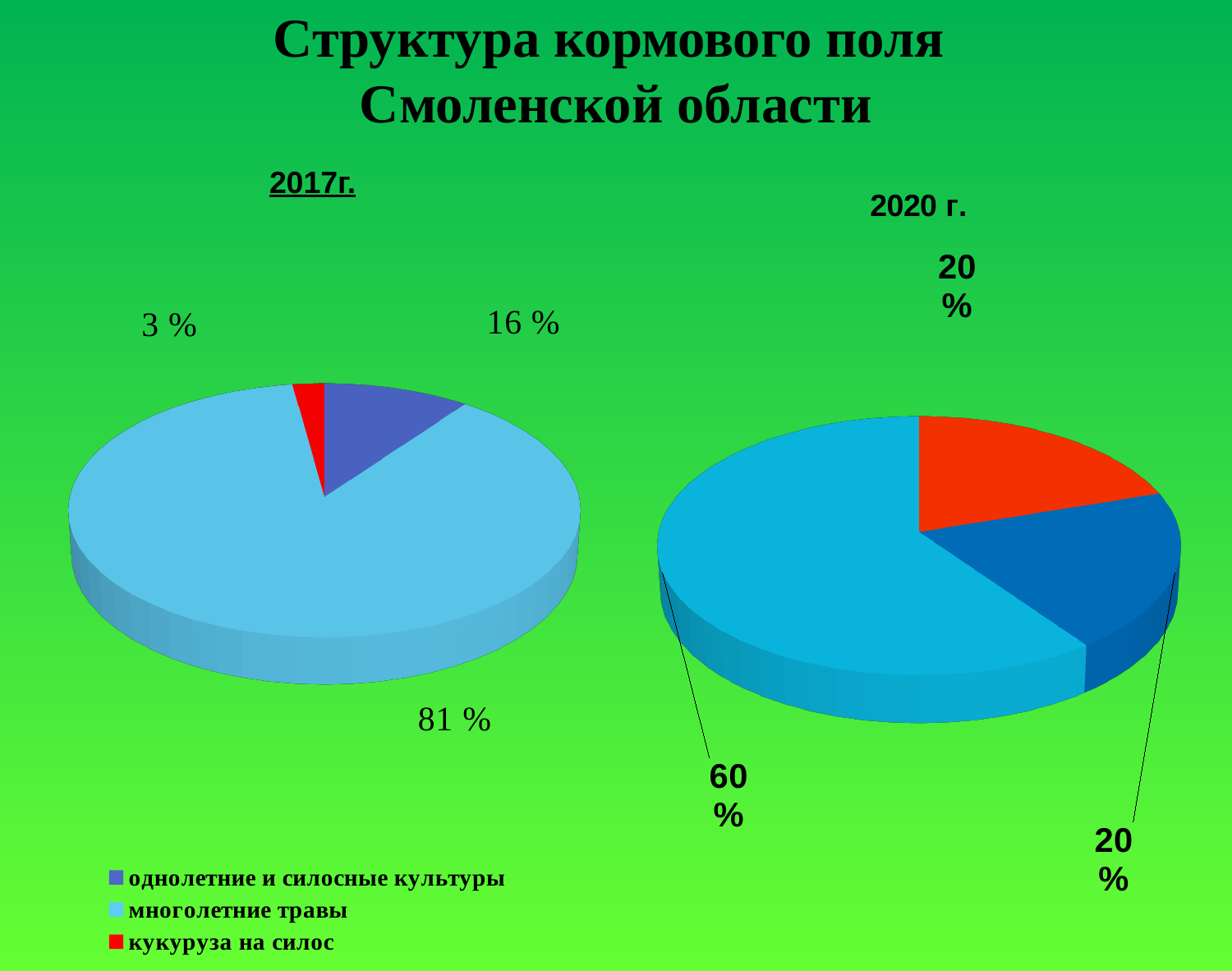
In the 2017 pie chart, what share is shown for однолетние и силосные культуры? 16 % In the 2017 pie chart, which category has the largest slice? многолетние травы How many entries does the legend list? 3 In the 2017 pie chart, what share is shown for многолетние травы? 81 % In the 2017 pie chart, which category has the smallest slice? кукуруза на силос What kind of charts are shown on the slide? Pie charts In the 2017 pie chart, what is the difference between the shares of многолетние травы and однолетние и силосные культуры? 65 % In the 2020 pie chart, what share is shown for the largest slice? 60 % In the 2017 pie chart, what share is shown for кукуруза на силос? 3 % In the 2017 pie chart, which is larger: the share of однолетние и силосные культуры or the share of кукуруза на силос? однолетние и силосные культуры How many slices does the 2020 pie chart have? 3 In the 2020 pie chart, what share is shown for the red slice? 20 %